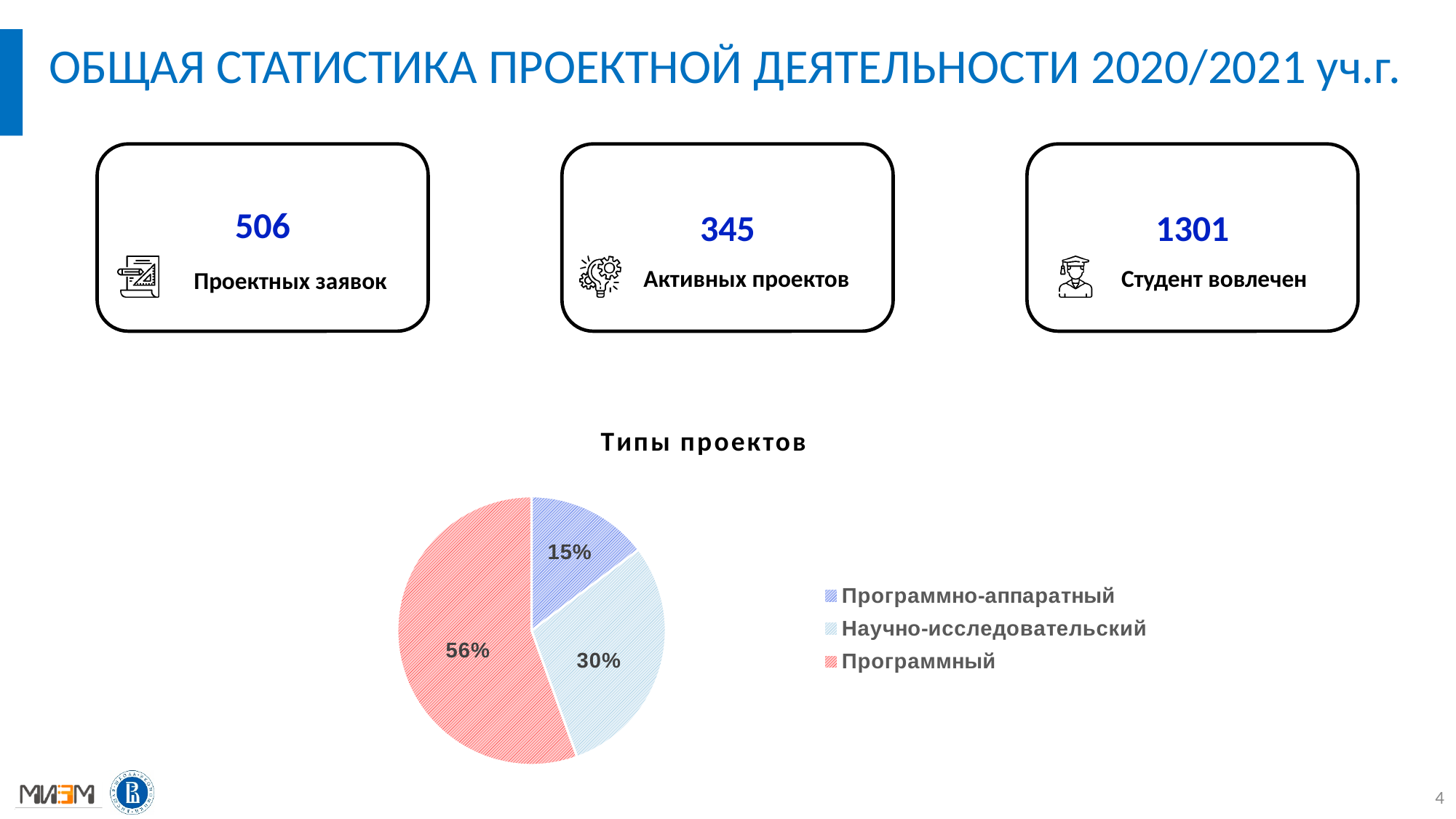
What kind of chart is shown under the title "Типы проектов"? Pie chart What share of the pie chart "Типы проектов" is Программно-аппаратный? 15% Which project type has the largest slice in the pie chart "Типы проектов"? Программный Which project type has the smallest slice in the pie chart "Типы проектов"? Программно-аппаратный How many entries does the legend of the pie chart "Типы проектов" list? 3 What share of the pie chart "Типы проектов" is Научно-исследовательский? 30% How many slices does the pie chart "Типы проектов" have? 3 In the pie chart "Типы проектов", which is larger: Научно-исследовательский or Программно-аппаратный? Научно-исследовательский What share of the pie chart "Типы проектов" is Программный? 56% In the pie chart "Типы проектов", which colour is used for the Программный slice? Red In the pie chart "Типы проектов", what is the difference in percentage points between Программный and Научно-исследовательский? 26 What is the title of the chart on the slide? Типы проектов